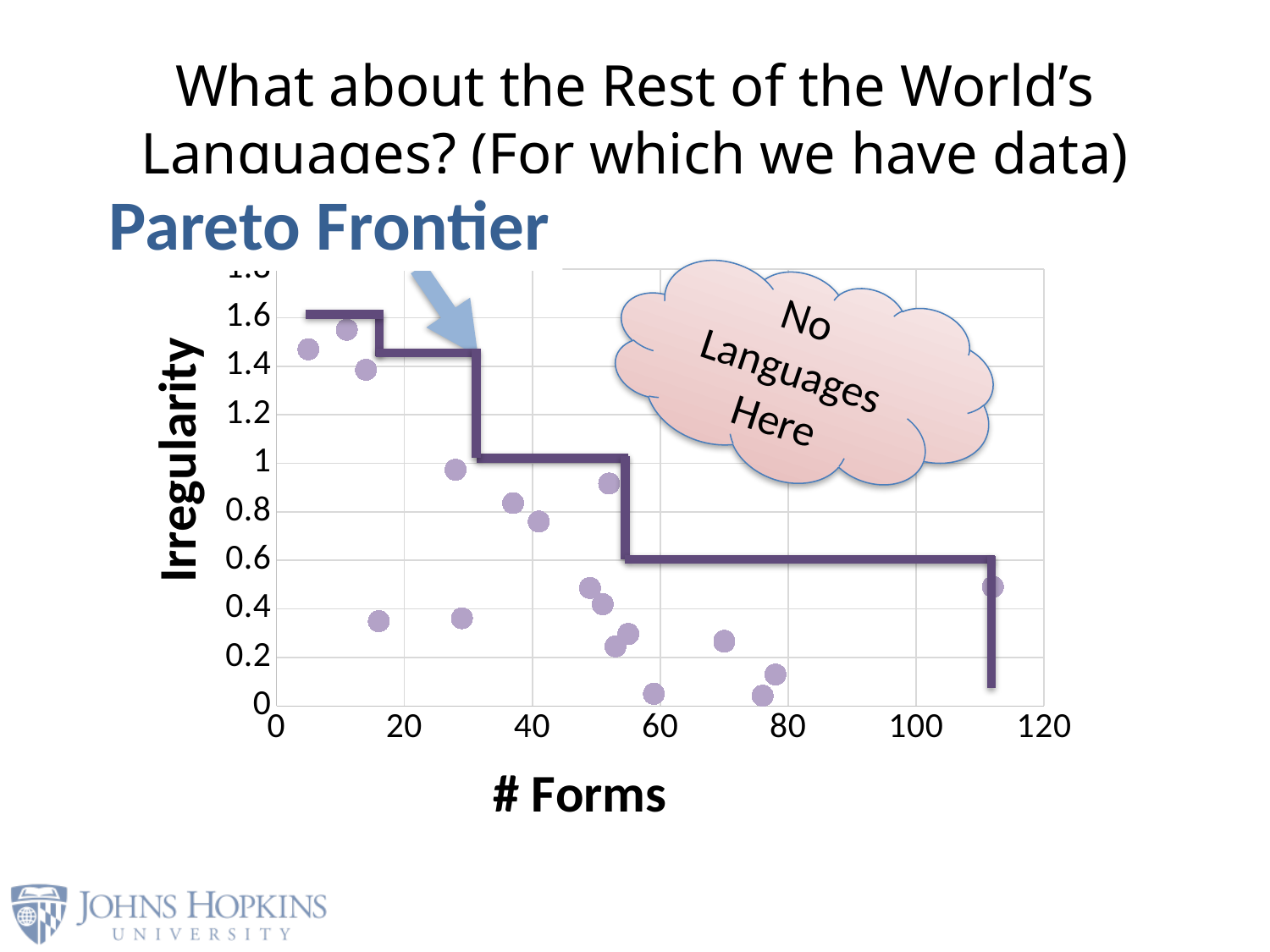
As # Forms increases along the x axis, does Irregularity generally rise or fall? fall Is the Irregularity of the lowest point on the chart greater or less than 0.2? less What is the label of the x axis? # Forms Is the # Forms value of the rightmost point greater or less than 100? greater What text is written inside the cloud shape on the chart? No Languages Here What kind of chart is shown on the slide? scatter plot Is the Irregularity of the rightmost point (the one with the most forms) greater or less than 0.6? less